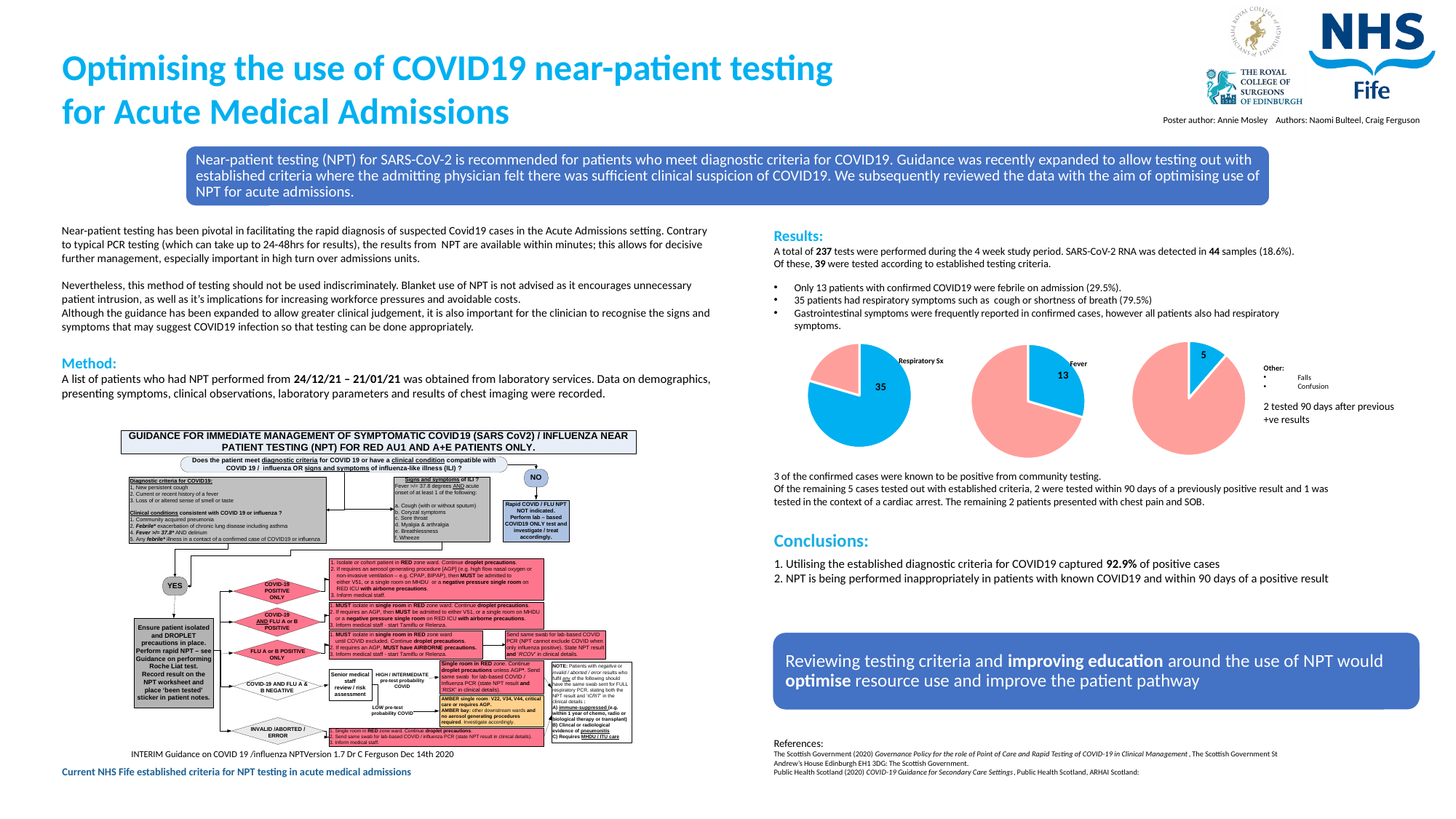
Which is larger: the labelled value in the Respiratory Sx pie chart or the labelled value in the Fever pie chart? Respiratory Sx In the Fever pie chart, what value is printed on the blue slice? 13 Which of the three pie charts has the smallest labelled blue slice? The third (rightmost) pie chart, labelled 5 How many pie charts are shown in the Results section? 3 How many slices does the Respiratory Sx pie chart have? 2 In the third (rightmost) pie chart, what value is printed on the blue slice? 5 In the Respiratory Sx pie chart, what value is printed on the blue slice? 35 What is the difference between the labelled value in the Respiratory Sx pie chart (35) and the labelled value in the Fever pie chart (13)? 22 In the Respiratory Sx pie chart, which slice is larger, the blue slice or the pink slice? Blue In the Fever pie chart, which slice is larger, the blue slice or the pink slice? Pink What two colours are used for the slices in the pie charts? Blue and pink What kind of chart is used to show the Respiratory Sx data? Pie chart